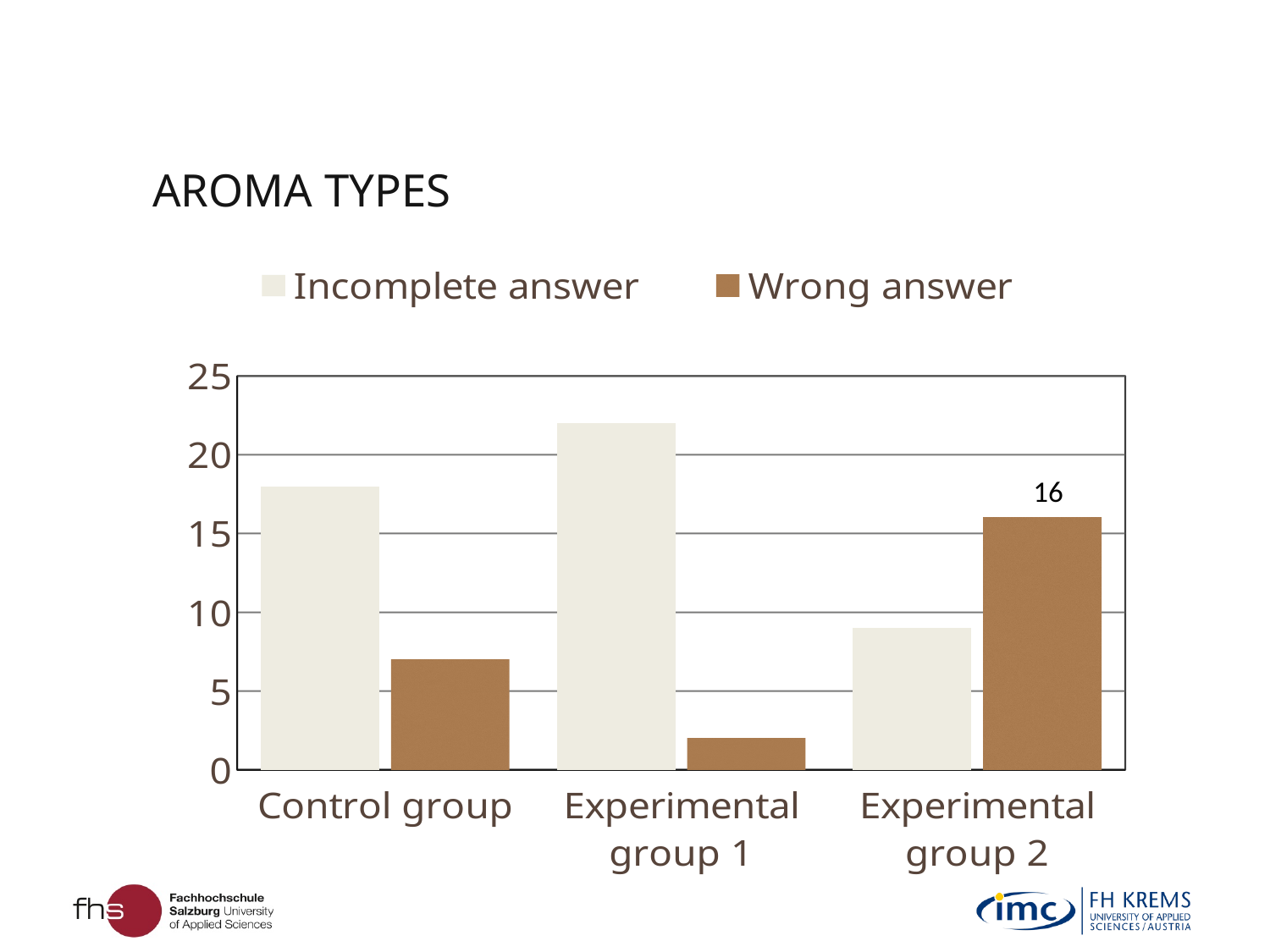
Is the Incomplete answer value for Control group greater or less than 15? greater Which group has the lowest Wrong answer bar? Experimental group 1 How many groups are shown on the x axis? 3 How many series does the legend list? 2 Which group has the lowest Incomplete answer bar? Experimental group 2 Is the Wrong answer value for Control group greater or less than 10? less Is the Incomplete answer value for Experimental group 1 greater or less than 20? greater Which group has the highest Incomplete answer bar? Experimental group 1 In Experimental group 2, which is larger: Incomplete answer or Wrong answer? Wrong answer What is the value for Wrong answer in Experimental group 2? 16 What type of chart is shown on the slide? Bar chart